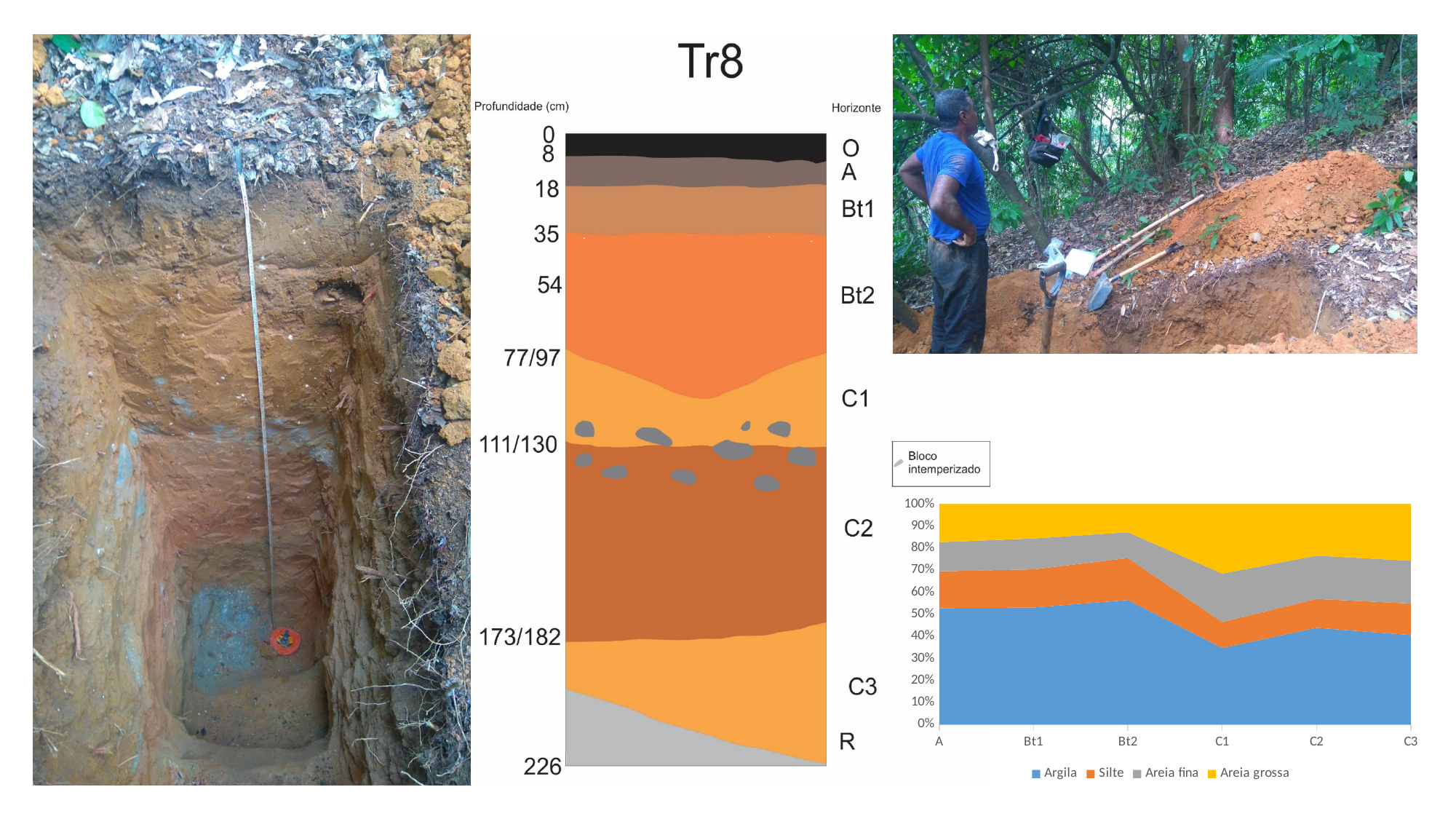
In the bottom-right area chart, which category has the largest share of Areia grossa? C1 In the bottom-right area chart, which series is listed last in the legend? Areia grossa How many series does the legend of the bottom-right area chart list? 4 In the bottom-right area chart, which category has the lowest share of Argila? C1 In the Tr8 soil profile diagram, at what depth in cm does the Bt2 horizon begin? 35 In the bottom-right area chart, is the share of Argila at C1 greater or less than 40%? less What kind of chart is the chart at the bottom right of the slide? area chart In the bottom-right area chart, is the share of Argila at Bt2 greater or less than 50%? greater In the bottom-right area chart, which series is shown in blue? Argila In the bottom-right area chart, is the share of Argila larger at Bt2 or at C1? Bt2 In the bottom-right area chart, does the share of Argila rise or fall from Bt2 to C1? fall How many categories are shown on the x axis of the bottom-right area chart? 6